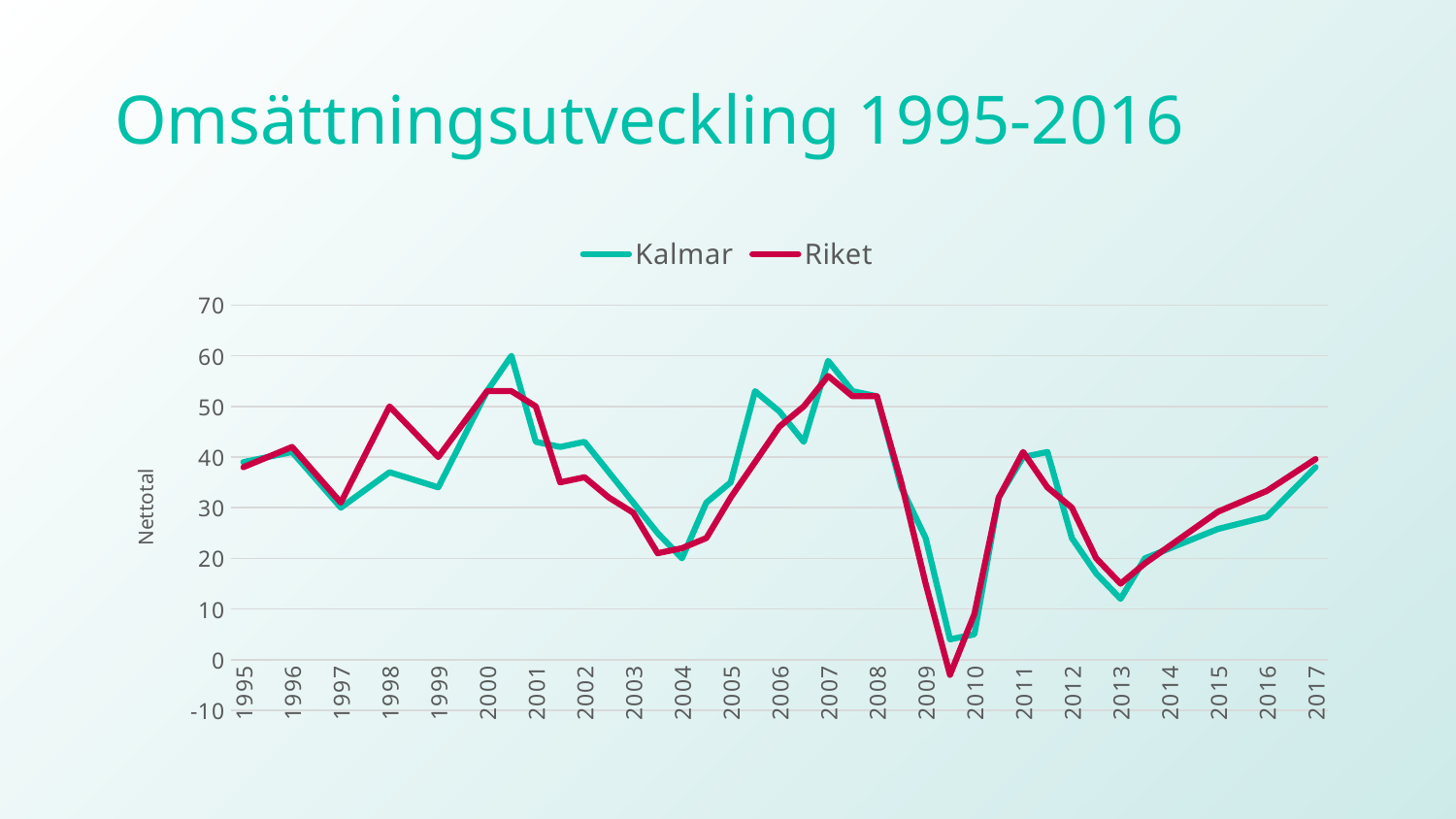
What is the title of the chart? Omsättningsutveckling 1995-2016 What kind of chart is shown on the slide? line chart Which series reaches the highest value anywhere on the chart? Kalmar At 1998, which series has the larger value, Kalmar or Riket? Riket Is the value for Kalmar at 2013 greater or less than 20? less Is the lowest value for Riket around 2009 greater or less than 10? less How many series does the legend list? 2 At 2005, which series has the larger value, Kalmar or Riket? Kalmar Is the value for Kalmar at its 2000 peak greater or less than 50? greater Do the values for both series rise or fall between 2007 and 2009? fall What is the label on the vertical axis? Nettotal